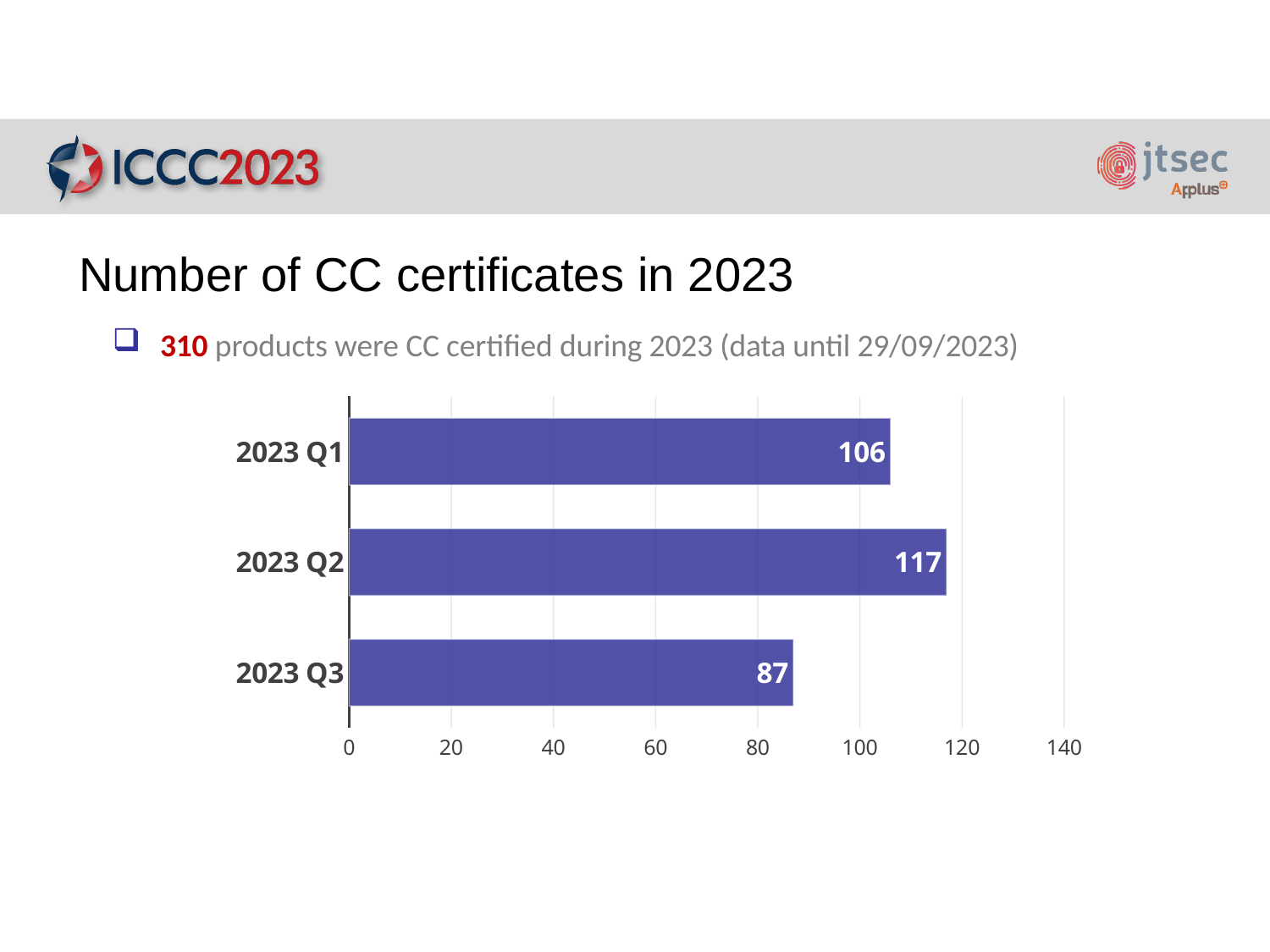
What kind of chart is shown on the slide? bar chart What is the number of CC certificates for 2023 Q2? 117 What is the difference between the number of certificates in 2023 Q2 and 2023 Q1? 11 What is the number of CC certificates for 2023 Q3? 87 What is the total number of CC certificates across the three quarters shown? 310 How many quarters are shown in the chart? 3 Which quarter has the lowest number of CC certificates? 2023 Q3 Is the value for 2023 Q2 greater or less than 100? greater Which quarter has the highest number of CC certificates? 2023 Q2 Which has more CC certificates, 2023 Q1 or 2023 Q3? 2023 Q1 What is the number of CC certificates for 2023 Q1? 106 What is the difference between the number of certificates in 2023 Q1 and 2023 Q3? 19